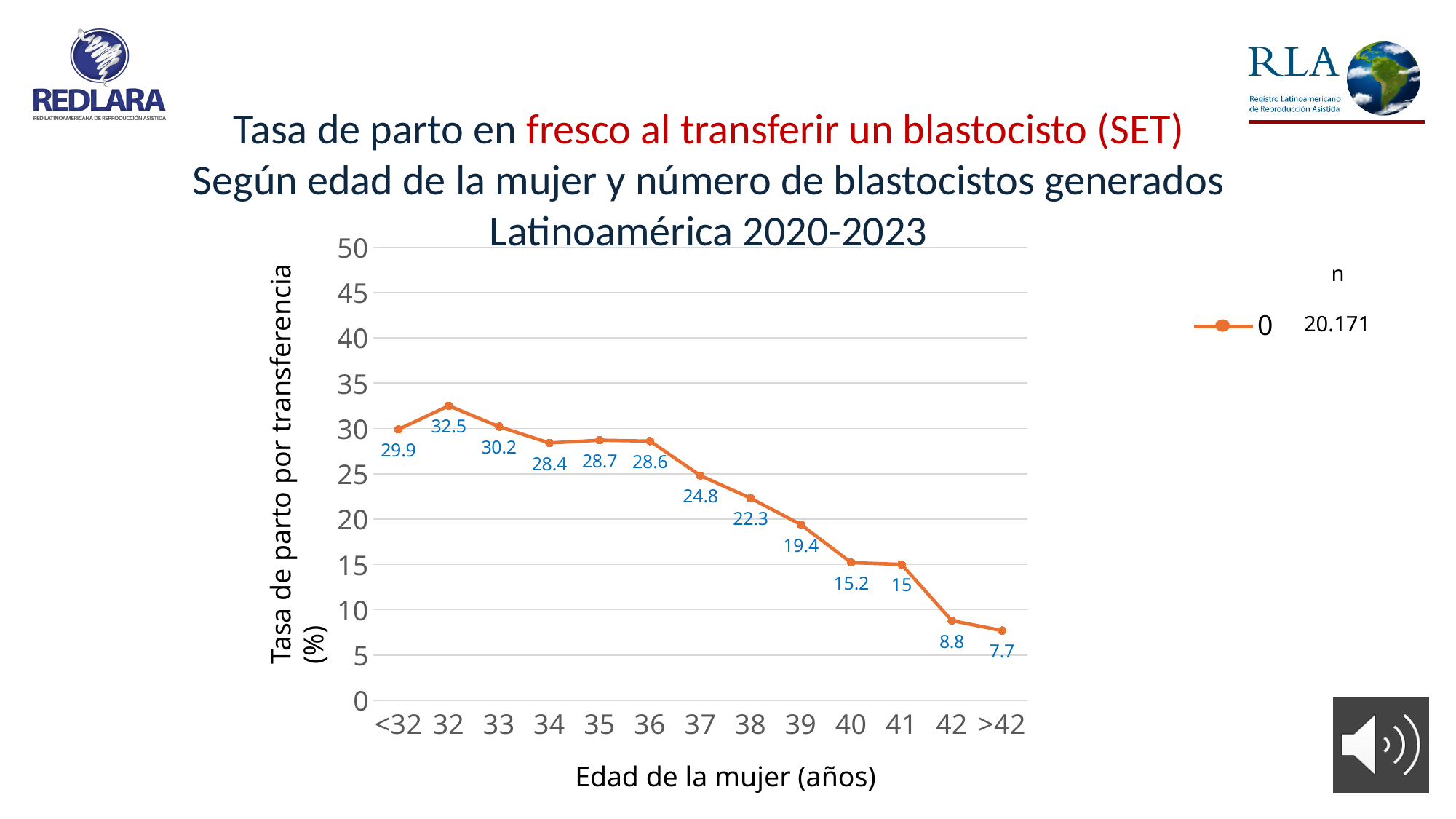
Which has a higher delivery rate per transfer, age 35 or age 37? 35 Is the delivery rate for women aged 40 greater or less than 20? less What is the delivery rate per transfer for women aged 32? 32.5 Which age group has the highest delivery rate per transfer? 32 What is the delivery rate per transfer for women aged 39? 19.4 What is the difference between the delivery rate at age 32 and at age 42? 23.7 What is the n value shown next to the legend? 20.171 What is the overall trend of the delivery rate from age 32 to >42? falling How many age categories are plotted on the x axis? 13 Which age group has the lowest delivery rate per transfer? >42 What is the delivery rate per transfer for women aged >42? 7.7 What kind of chart is shown on the slide? line chart